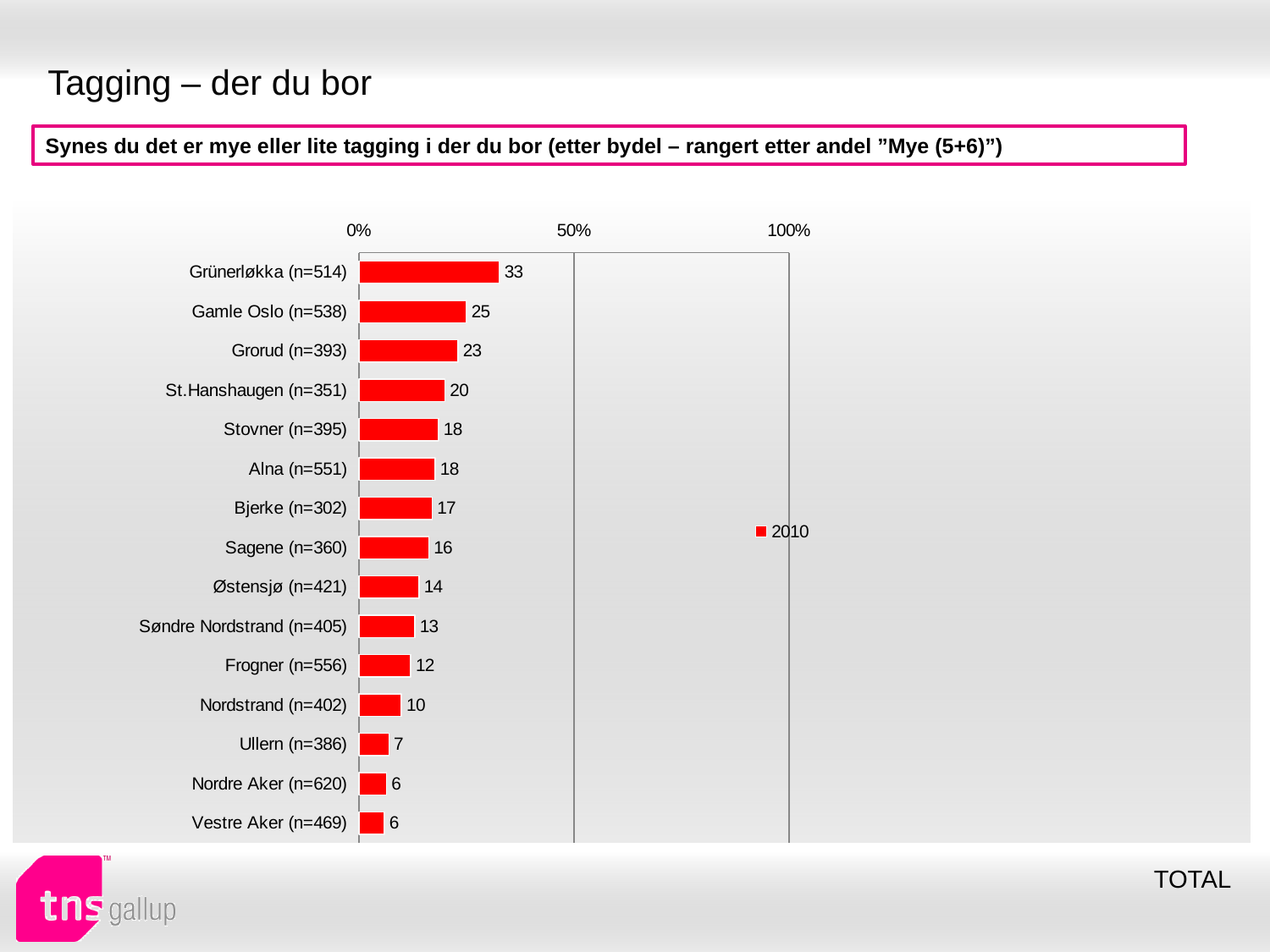
What series name is shown in the legend? 2010 What is the value for Grünerløkka (n=514)? 33 Is the value for Grünerløkka (n=514) greater or less than 50%? less What is the difference between the values for Gamle Oslo (n=538) and Grorud (n=393)? 2 Which is larger, the value for St.Hanshaugen (n=351) or the value for Østensjø (n=421)? St.Hanshaugen (n=351) What kind of chart is shown on the slide? bar chart What is the difference between the values for Grünerløkka (n=514) and Vestre Aker (n=469)? 27 Which category has the highest value? Grünerløkka (n=514) How many series does the legend list? 1 What is the value for Frogner (n=556)? 12 How many categories are shown in the chart? 15 What is the value for Sagene (n=360)? 16